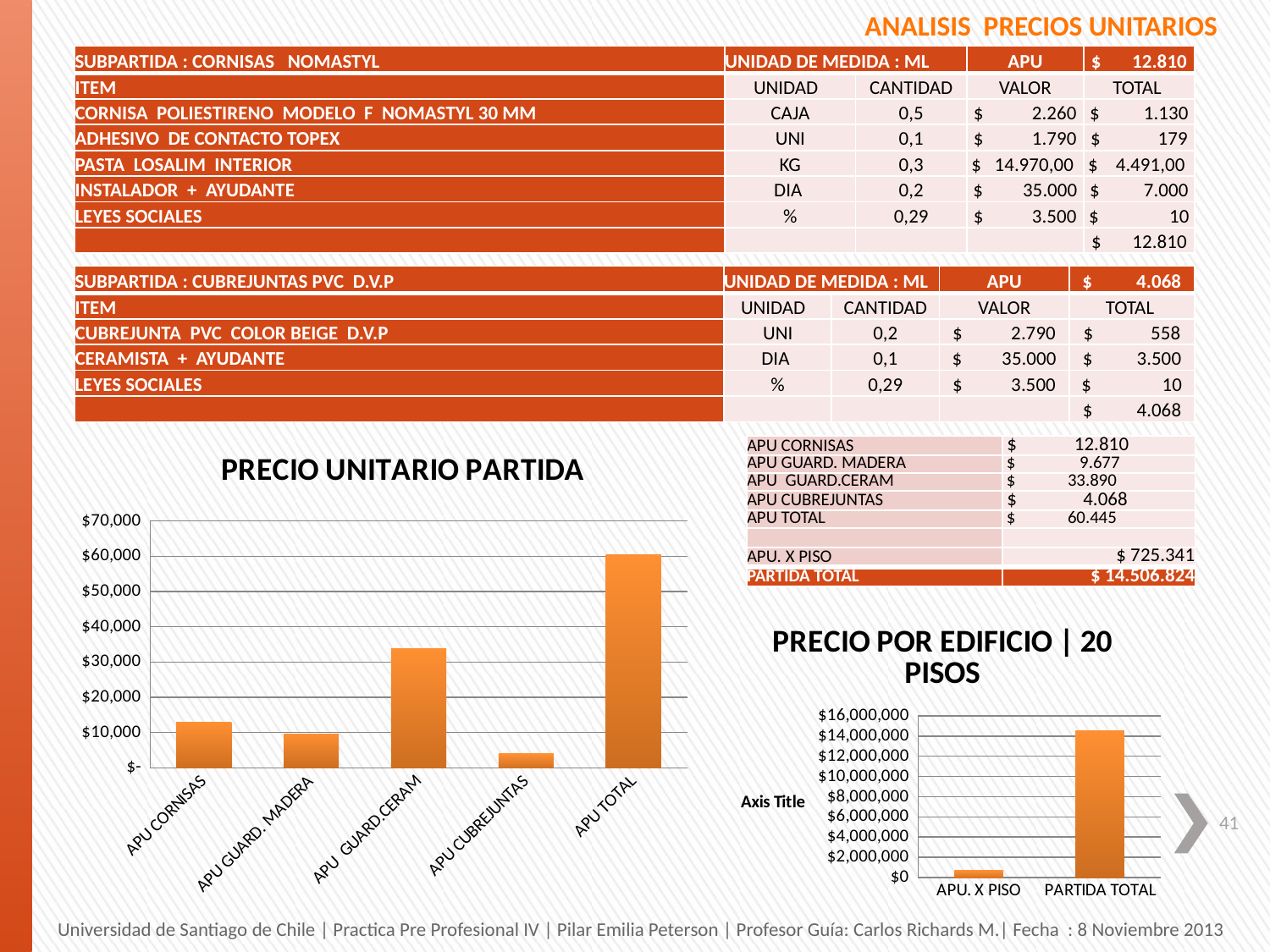
What kind of chart is the "PRECIO UNITARIO PARTIDA" chart? bar chart In the "PRECIO POR EDIFICIO | 20 PISOS" chart, which category has the higher value? PARTIDA TOTAL In the "PRECIO UNITARIO PARTIDA" chart, is the value for APU GUARD.CERAM greater or less than $30,000? greater How many categories are plotted in the "PRECIO UNITARIO PARTIDA" chart? 5 What is the title of the bar chart on the left side of the slide? PRECIO UNITARIO PARTIDA In the "PRECIO UNITARIO PARTIDA" chart, is the value for APU CORNISAS greater or less than $20,000? less In the "PRECIO UNITARIO PARTIDA" chart, which category has the lowest value? APU CUBREJUNTAS In the "PRECIO UNITARIO PARTIDA" chart, which category has the highest value? APU TOTAL In the "PRECIO UNITARIO PARTIDA" chart, which is larger: APU GUARD.CERAM or APU CORNISAS? APU GUARD.CERAM In the "PRECIO UNITARIO PARTIDA" chart, is the value for APU TOTAL greater or less than $50,000? greater How many categories are plotted in the "PRECIO POR EDIFICIO | 20 PISOS" chart? 2